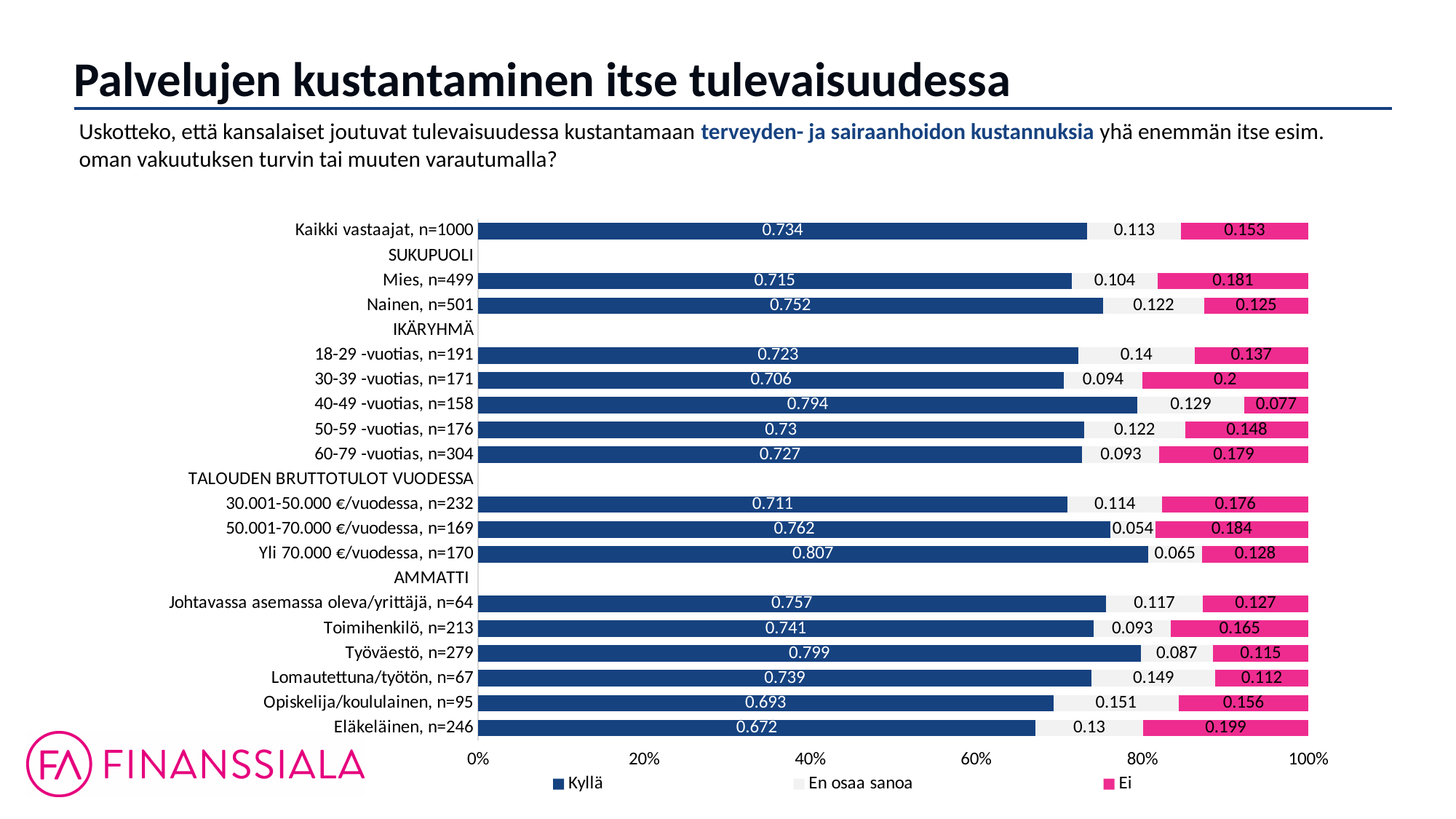
What are the three legend entries of the chart? Kyllä, En osaa sanoa, Ei Which group has the lowest Kyllä value? Eläkeläinen, n=246 What is the En osaa sanoa value for 50.001-70.000 €/vuodessa, n=169? 0.054 Which has the larger Kyllä value, Työväestö, n=279 or Toimihenkilö, n=213? Työväestö, n=279 What is the Ei value for 30-39 -vuotias, n=171? 0.2 What is the Kyllä value for Kaikki vastaajat, n=1000? 0.734 Which group has the lowest Ei value? 40-49 -vuotias, n=158 Which group has the highest Kyllä value? Yli 70.000 €/vuodessa, n=170 What kind of chart is shown on the slide? Stacked bar chart Is the Kyllä value for Eläkeläinen, n=246 greater or less than 80%? less How many series does the legend list? 3 What is the difference between the Kyllä values for Nainen, n=501 and Mies, n=499? 0.037